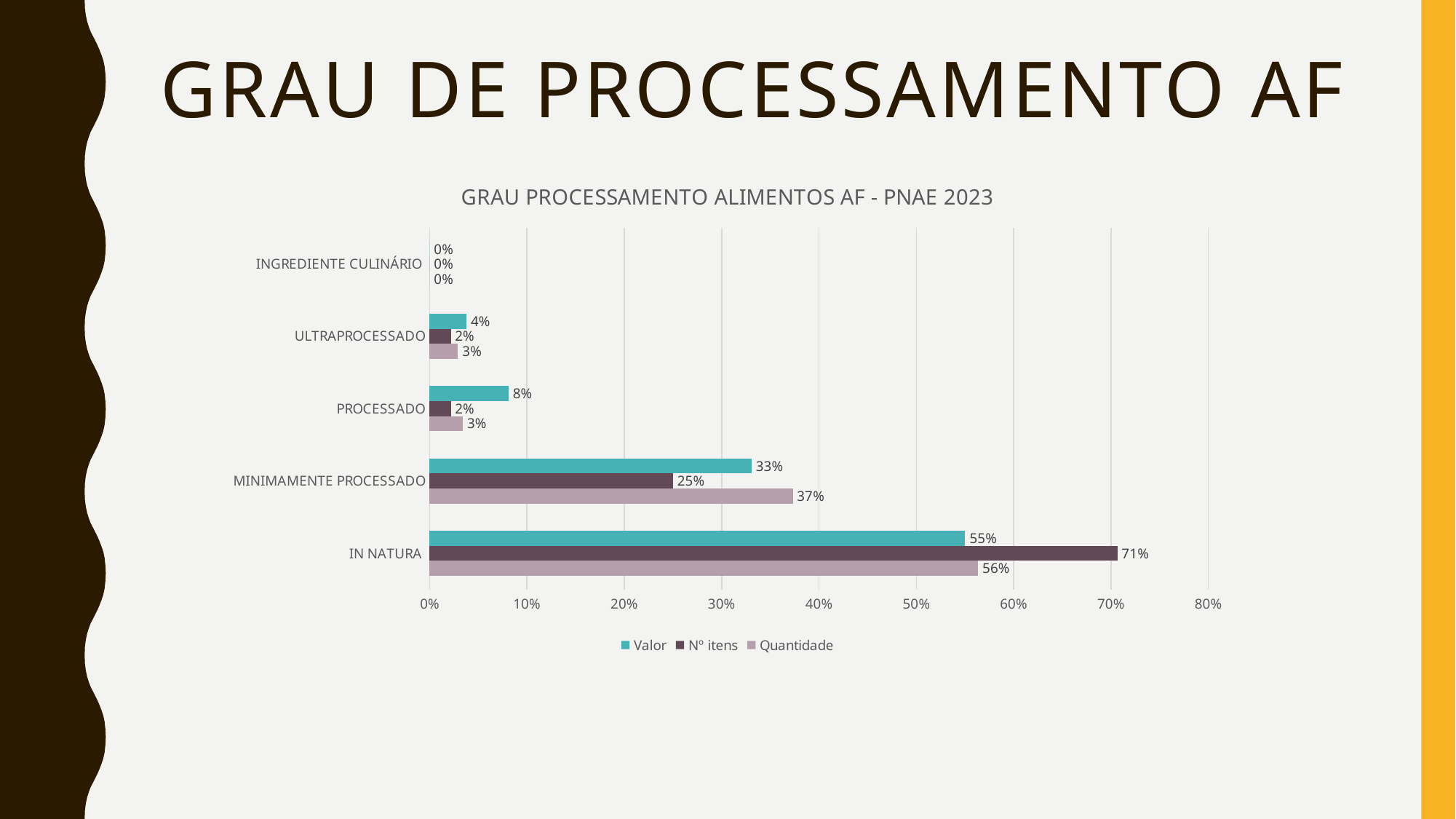
What is the difference between the Nº itens value and the Valor value for IN NATURA? 16% What is the Valor value for IN NATURA? 55% What is the Quantidade value for ULTRAPROCESSADO? 3% What is the Valor value for PROCESSADO? 8% Which category has the highest Nº itens value? IN NATURA Which category has the lowest Valor value? INGREDIENTE CULINÁRIO For MINIMAMENTE PROCESSADO, which is larger: the Valor value or the Quantidade value? Quantidade What kind of chart is shown on the slide? Bar chart How many categories are shown on the y axis? 5 What is the Nº itens value for MINIMAMENTE PROCESSADO? 25% What is the title of the chart? GRAU PROCESSAMENTO ALIMENTOS AF - PNAE 2023 How many series does the legend list? 3